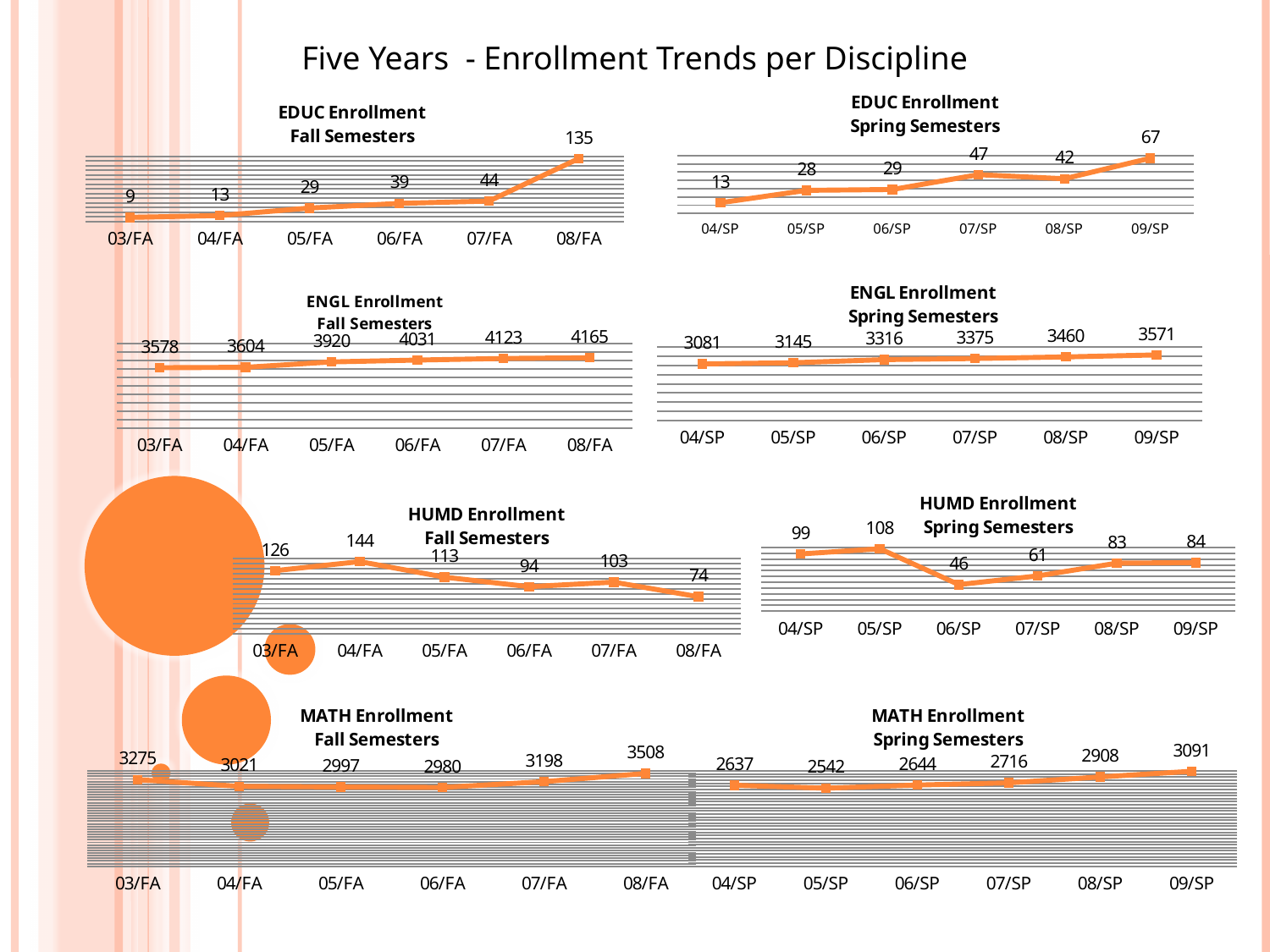
What kind of chart is the ENGL Enrollment Spring Semesters chart? Line chart In the EDUC Enrollment Spring Semesters chart, which semester has the lowest enrollment? 04/SP In the MATH Enrollment Fall Semesters chart, what is the value for 06/FA? 2980 In the MATH Enrollment Spring Semesters chart, what is the difference between the 09/SP and 04/SP values? 454 In the HUMD Enrollment Fall Semesters chart, which semester has the highest enrollment? 04/FA How many charts are shown on the slide? 8 In the ENGL Enrollment Spring Semesters chart, what is the value for 07/SP? 3375 How many data points are plotted in the EDUC Enrollment Fall Semesters chart? 6 In the HUMD Enrollment Spring Semesters chart, which is larger, the value for 05/SP or the value for 06/SP? 05/SP In the ENGL Enrollment Spring Semesters chart, do the values rise or fall from 04/SP to 09/SP? Rise In the EDUC Enrollment Fall Semesters chart, what is the value for 08/FA? 135 In the ENGL Enrollment Fall Semesters chart, what is the difference between the 08/FA and 03/FA values? 587